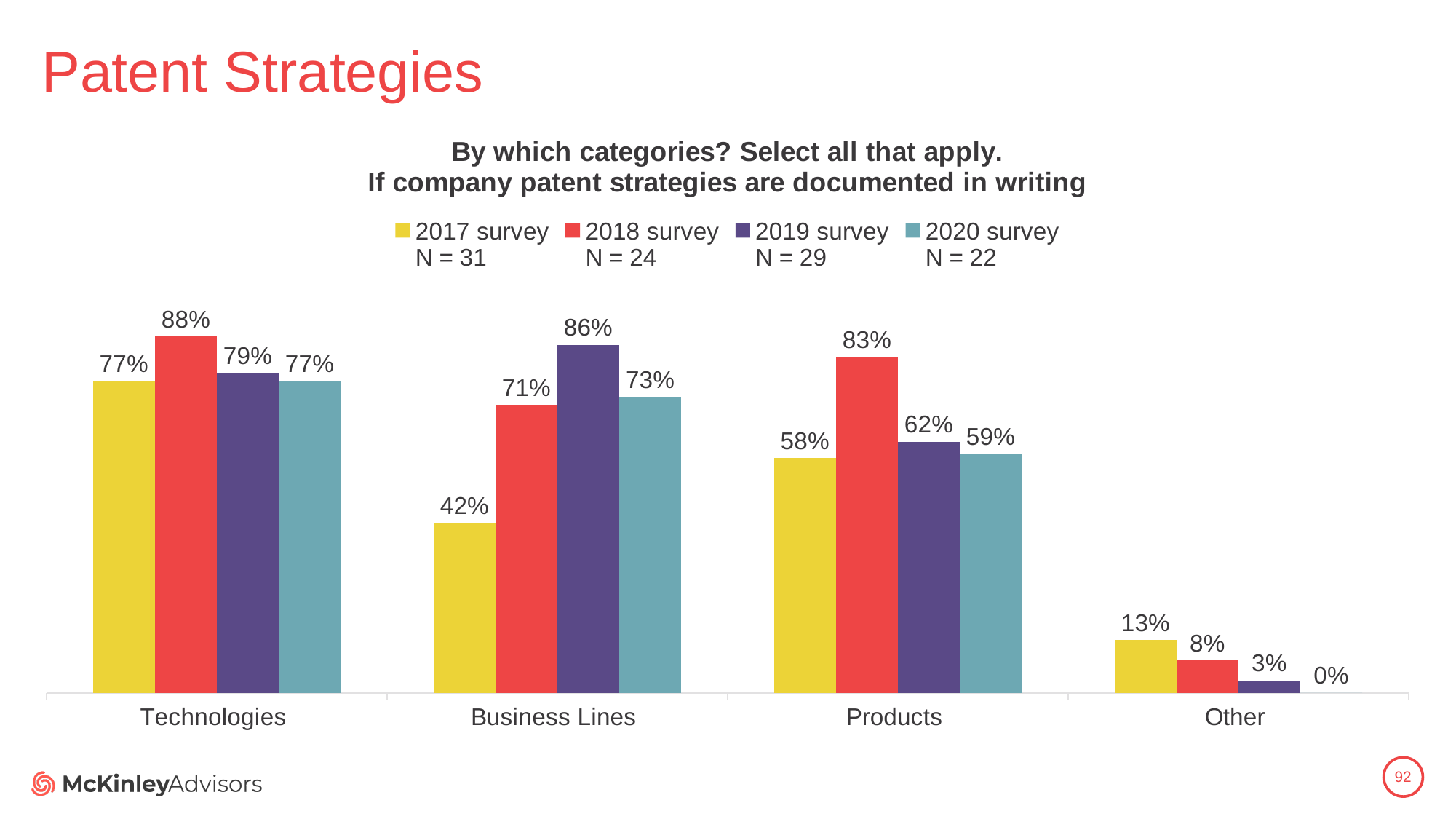
What is the difference between the 2018 survey and 2017 survey values for Business Lines? 29% What is the value for Other in the 2019 survey? 3% What is the value for Technologies in the 2018 survey? 88% What is the sample size (N) for the 2020 survey shown in the legend? N = 22 Which category has the lowest value in the 2017 survey? Other Which is larger for Products: the 2018 survey value or the 2019 survey value? 2018 survey Which category has the highest value in the 2019 survey? Business Lines How many series does the legend list? 4 What is the value for Products in the 2020 survey? 59% What kind of chart is shown on the slide? Bar chart How many categories are shown on the x axis? 4 What is the value for Business Lines in the 2017 survey? 42%